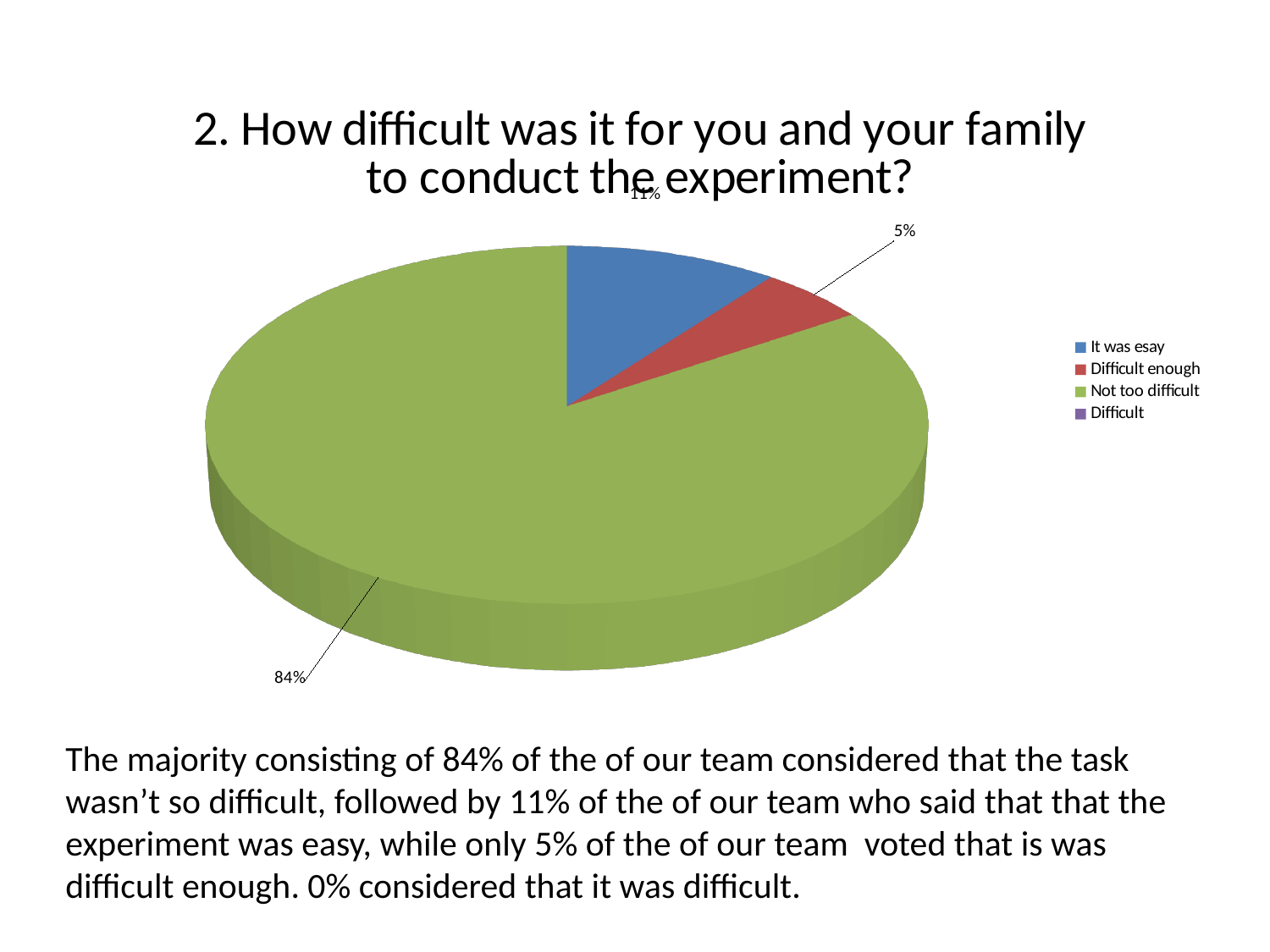
What percentage of the pie is labelled for 'Not too difficult'? 84% Which category has the largest slice of the pie? Not too difficult What is the difference in percentage points between 'It was esay' and 'Difficult enough'? 6% What is the difference in percentage points between 'Not too difficult' and 'It was esay'? 73% What is the title of the chart? 2. How difficult was it for you and your family to conduct the experiment? What share of the pie does 'Difficult enough' represent? 5% What percentage is shown for 'It was esay'? 11% Which is larger, the slice for 'It was esay' or the slice for 'Difficult enough'? It was esay How many entries does the legend list? 4 What colour is the 'Not too difficult' slice? green What kind of chart is shown on the slide? pie chart What percentage is shown for 'Difficult enough'? 5%